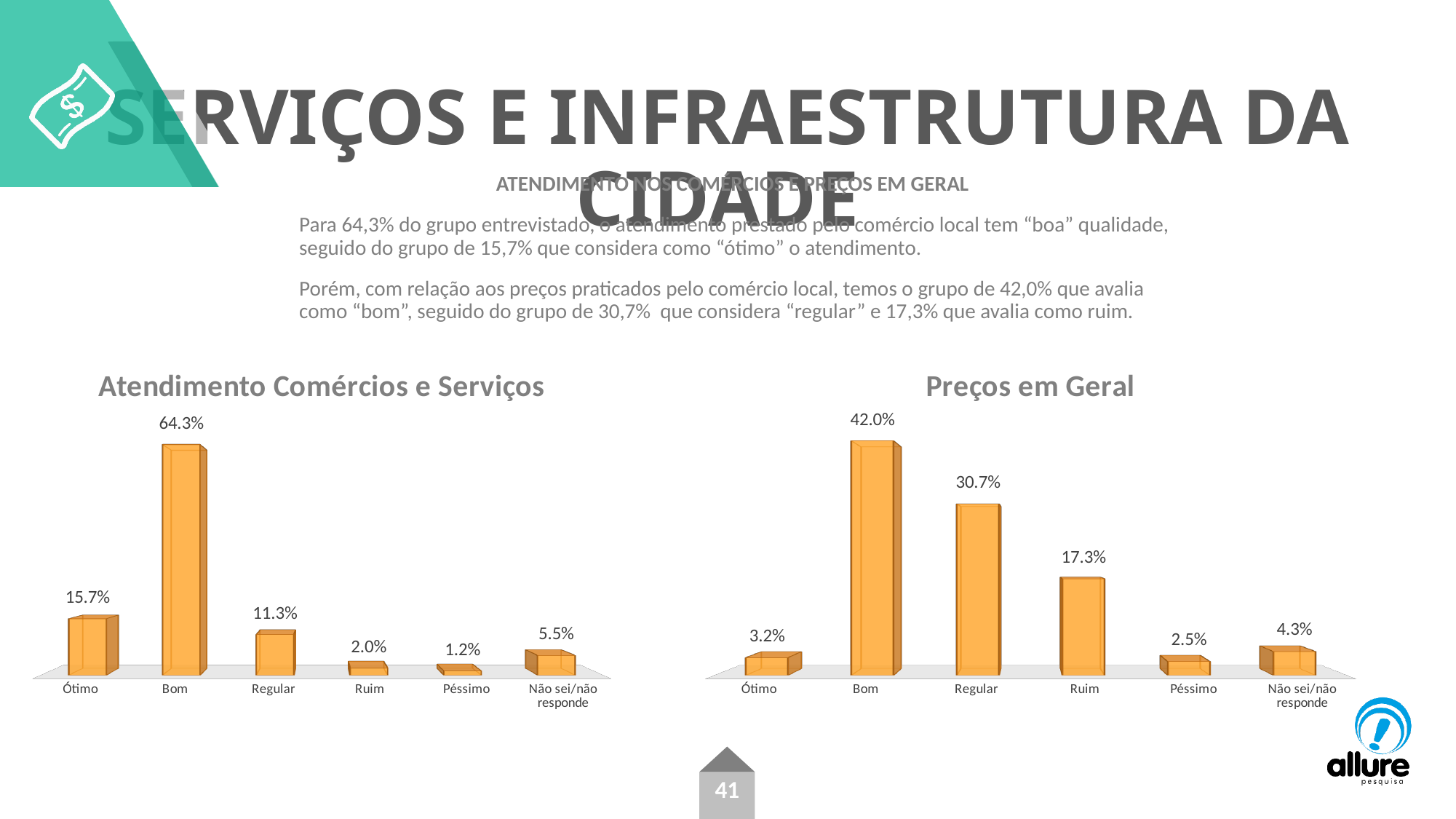
In the 'Atendimento Comércios e Serviços' chart, which category has the lowest value? Péssimo How many categories are shown in the 'Preços em Geral' chart? 6 In the 'Atendimento Comércios e Serviços' chart, which is larger, Ótimo or Regular? Ótimo In the 'Preços em Geral' chart, which is larger, Ótimo or Péssimo? Ótimo In the 'Preços em Geral' chart, what is the value for Não sei/não responde? 4.3% In the 'Preços em Geral' chart, what is the difference between Bom and Regular? 11.3% In the 'Atendimento Comércios e Serviços' chart, what is the value for Bom? 64.3% In the 'Preços em Geral' chart, which category has the highest value? Bom In the 'Preços em Geral' chart, what is the value for Regular? 30.7% What is the title of the chart on the right side of the slide? Preços em Geral In the 'Atendimento Comércios e Serviços' chart, what is the difference between Ótimo and Regular? 4.4% What kind of chart is 'Atendimento Comércios e Serviços'? Bar chart